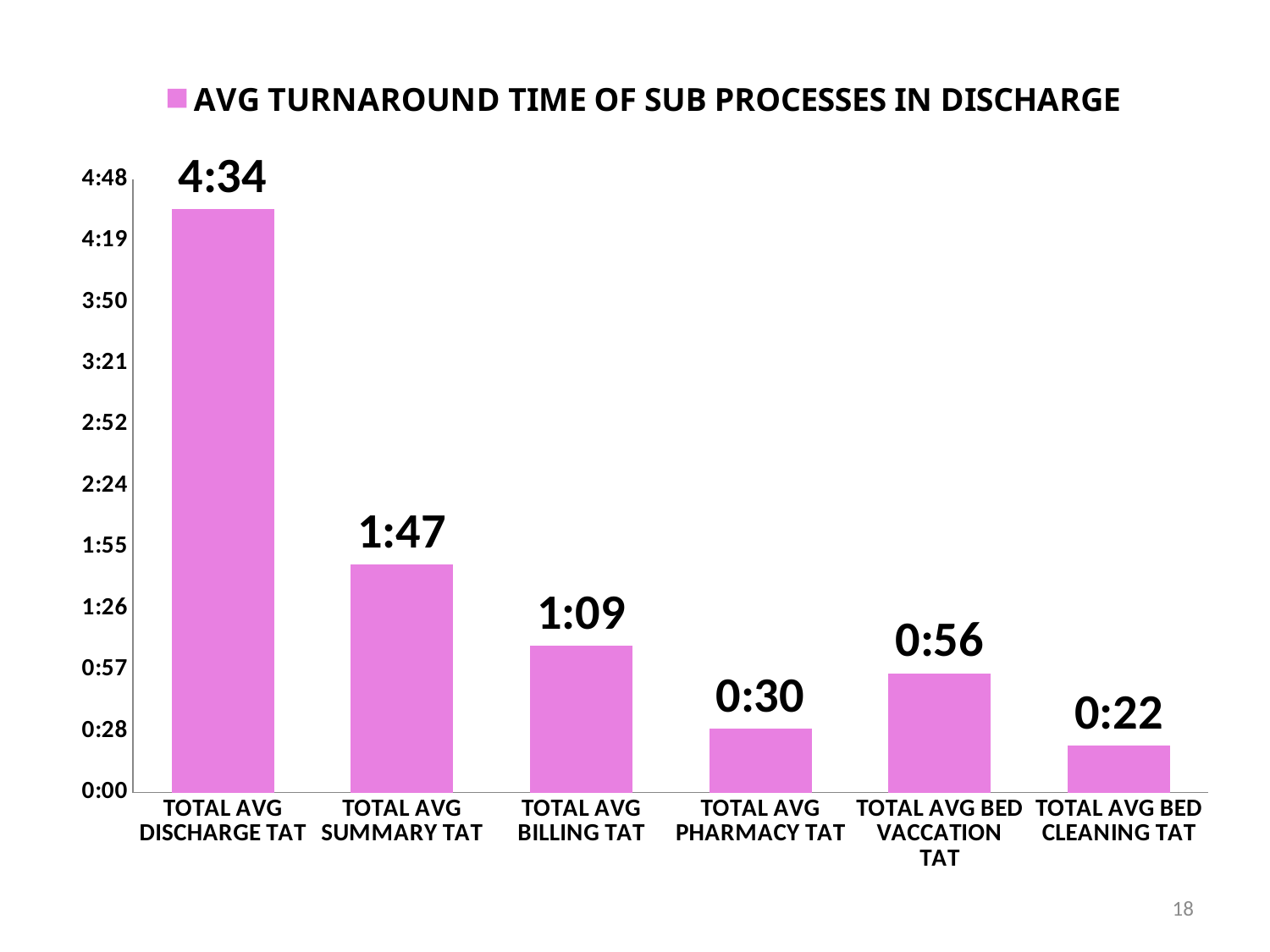
What is the value for Total Avg Bed Cleaning TAT? 0:22 Which category has the lowest value? Total Avg Bed Cleaning TAT What kind of chart is shown on the slide? Bar chart What is the value for Total Avg Billing TAT? 1:09 How many categories are shown on the x axis? 6 What is the value for Total Avg Summary TAT? 1:47 What is the legend entry shown above the chart? AVG TURNAROUND TIME OF SUB PROCESSES IN DISCHARGE What is the value for Total Avg Bed Vaccation TAT? 0:56 Which category has the highest value? Total Avg Discharge TAT What is the value for Total Avg Pharmacy TAT? 0:30 Which is larger, the value for Total Avg Pharmacy TAT or Total Avg Bed Vaccation TAT? Total Avg Bed Vaccation TAT What is the value for Total Avg Discharge TAT? 4:34